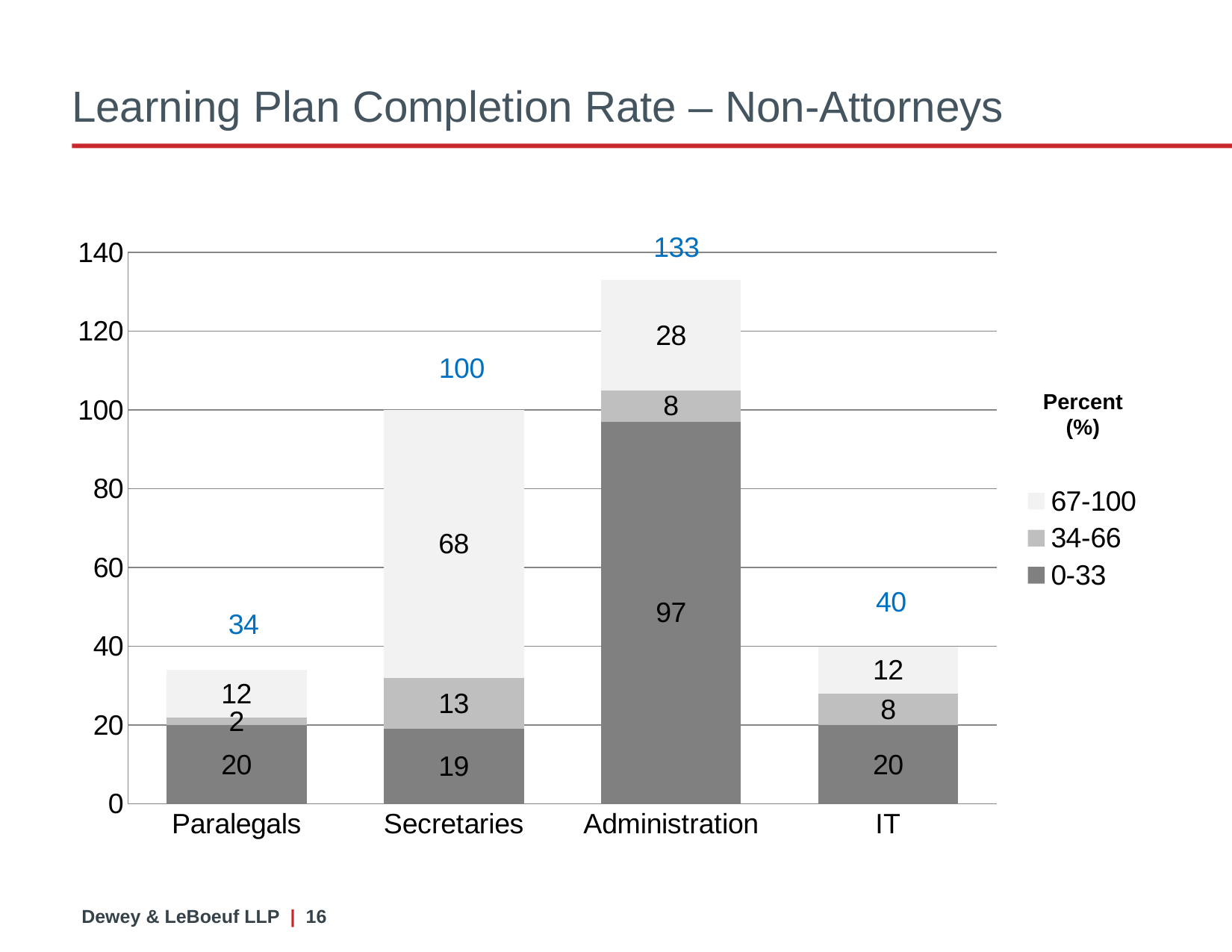
What is the value of the 0-33 segment for Administration? 97 What is the value of the 67-100 segment for Secretaries? 68 Which category has the lowest stacked bar total? Paralegals What kind of chart is shown on the slide? Stacked bar chart How many categories are shown on the x axis? 4 What is the difference between the stacked bar totals for Secretaries and IT? 60 What is the total of the stacked bar for Paralegals? 34 What is the total of the stacked bar for Administration? 133 How many series does the legend list? 3 Which category has the highest stacked bar total? Administration What is the value of the 34-66 segment for IT? 8 Which is larger, the 67-100 segment for Paralegals or the 67-100 segment for Administration? Administration